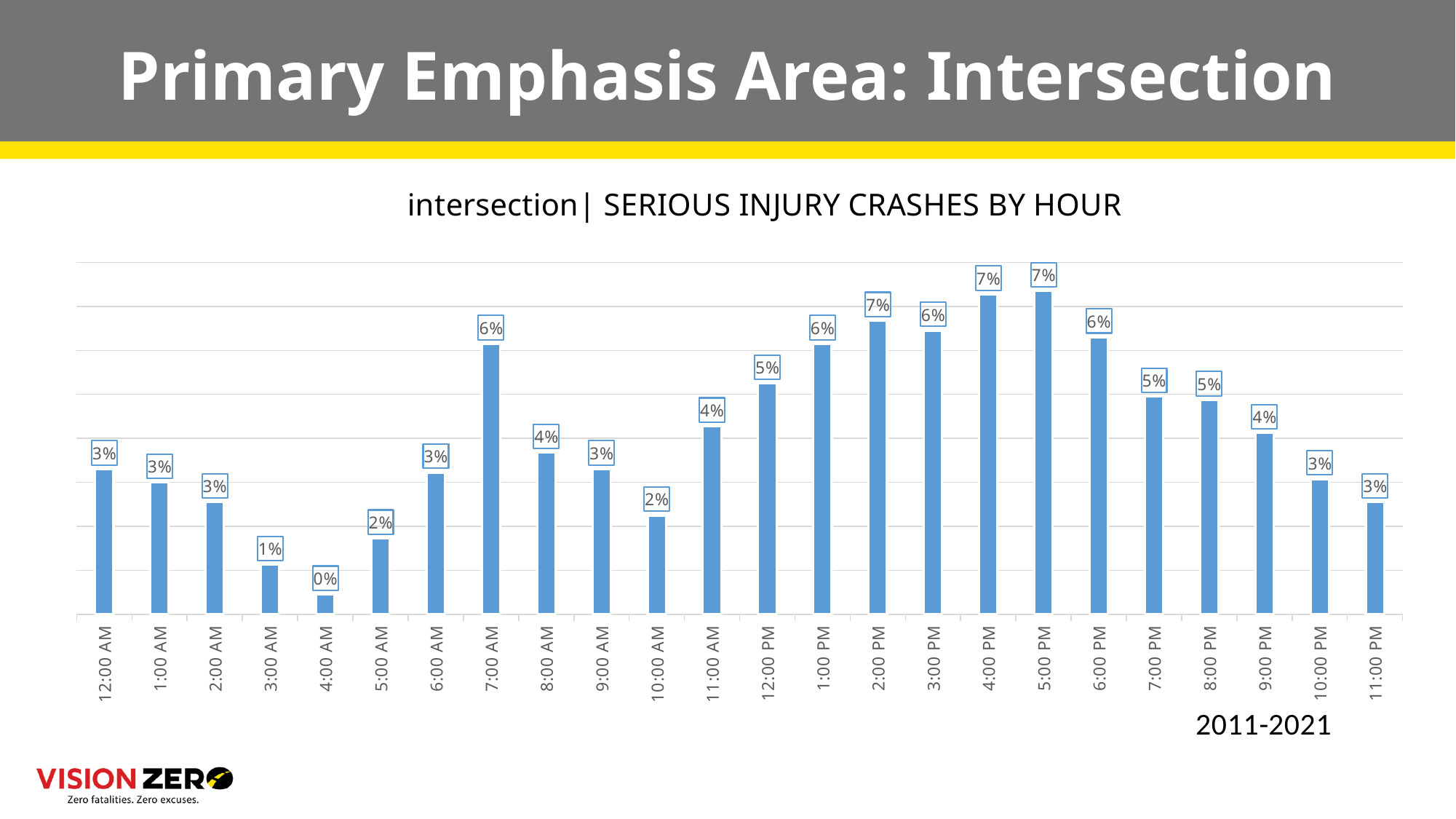
What is the value for 10:00 AM? 2% What is the value for 7:00 AM? 6% What is the difference between the values for 7:00 AM and 4:00 AM? 6% What is the difference between the values for 5:00 PM and 11:00 PM? 4% What kind of chart is this? Bar chart What is the value for 9:00 PM? 4% What is the value for 4:00 PM? 7% Do the values rise or fall from 6:00 PM to 11:00 PM? Fall Which hour has the lowest value? 4:00 AM What time period is shown below the chart? 2011-2021 Which is larger, the value for 7:00 AM or the value for 8:00 AM? 7:00 AM How many hours are shown on the x axis? 24